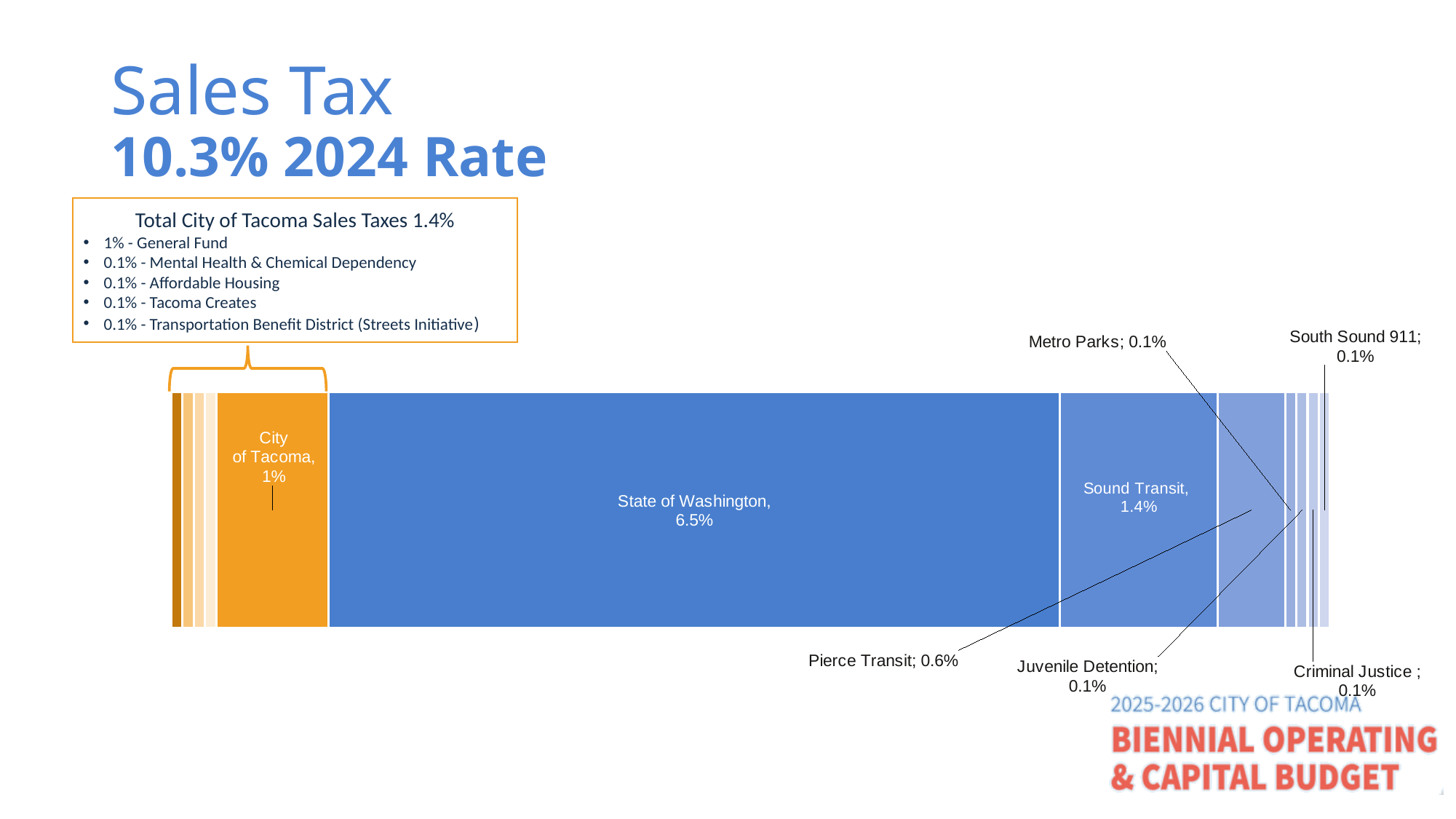
What is the difference between the Sound Transit rate and the City of Tacoma rate? 0.4% What is the rate shown for Pierce Transit? 0.6% What kind of chart is shown on the slide? bar chart Which labeled segment has the largest rate? State of Washington What is the difference between the State of Washington rate and the Sound Transit rate? 5.1% According to the text box, what is the total City of Tacoma sales tax rate? 1.4% What is the rate shown for Sound Transit? 1.4% What total 2024 sales tax rate does the slide title state? 10.3% What is the sales tax rate for the State of Washington segment? 6.5% What is the rate shown for the City of Tacoma segment in the bar? 1% What is the rate shown for Metro Parks? 0.1% Which is larger, the Sound Transit rate or the Pierce Transit rate? Sound Transit